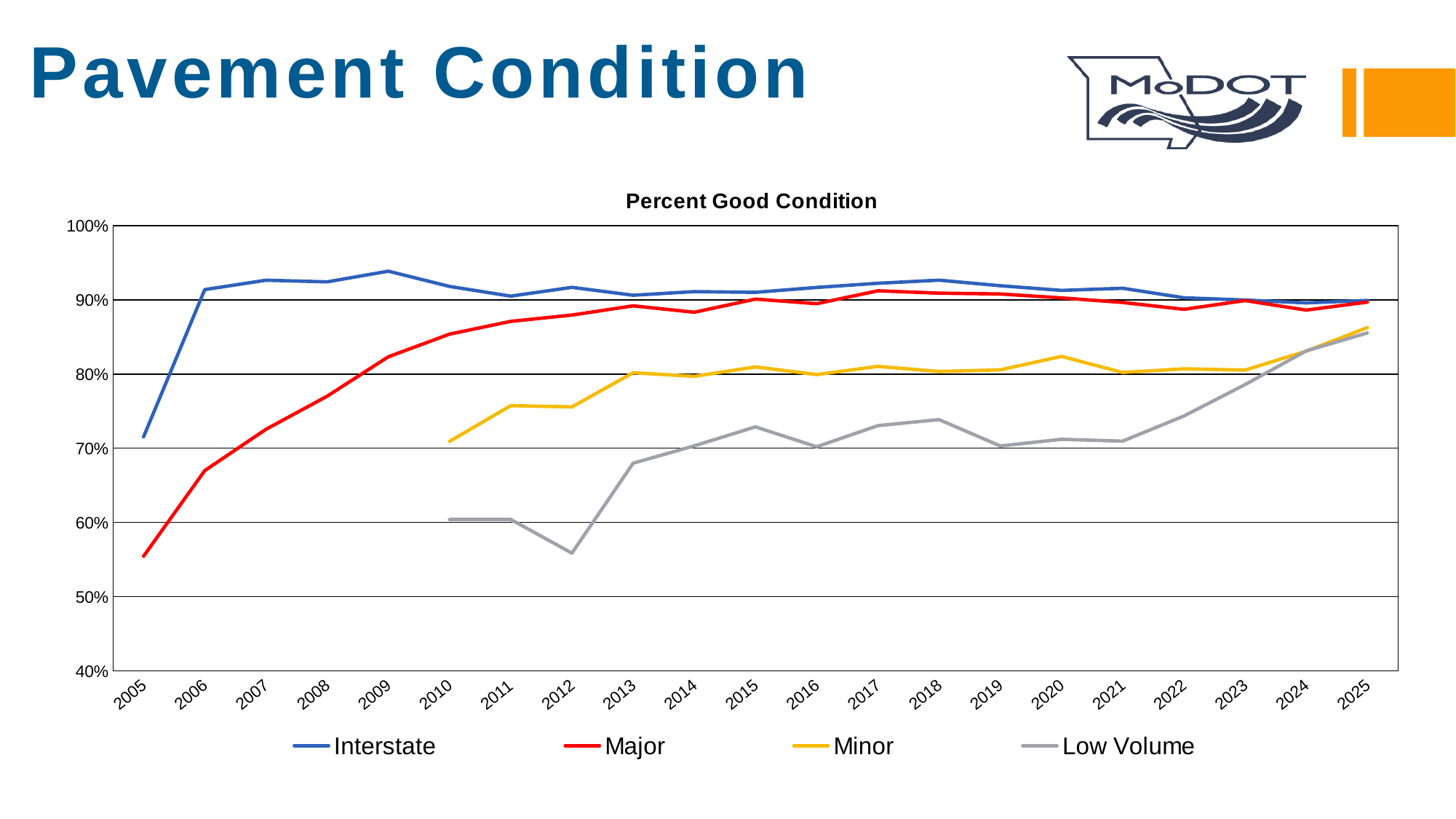
Is the value for Major in 2005 greater or less than 60%? less Is the value for Interstate in 2009 greater or less than 90%? greater What kind of chart is shown on the slide? line chart Is the value for Low Volume in 2012 greater or less than 60%? less Does the Major series rise or fall from 2005 to 2013? rise Which series has the lowest value in 2013? Low Volume How many series does the legend list? 4 What is the title of the chart? Percent Good Condition Which series is drawn in grey? Low Volume How many years are shown along the x axis? 21 Which series has the highest value in 2010? Interstate